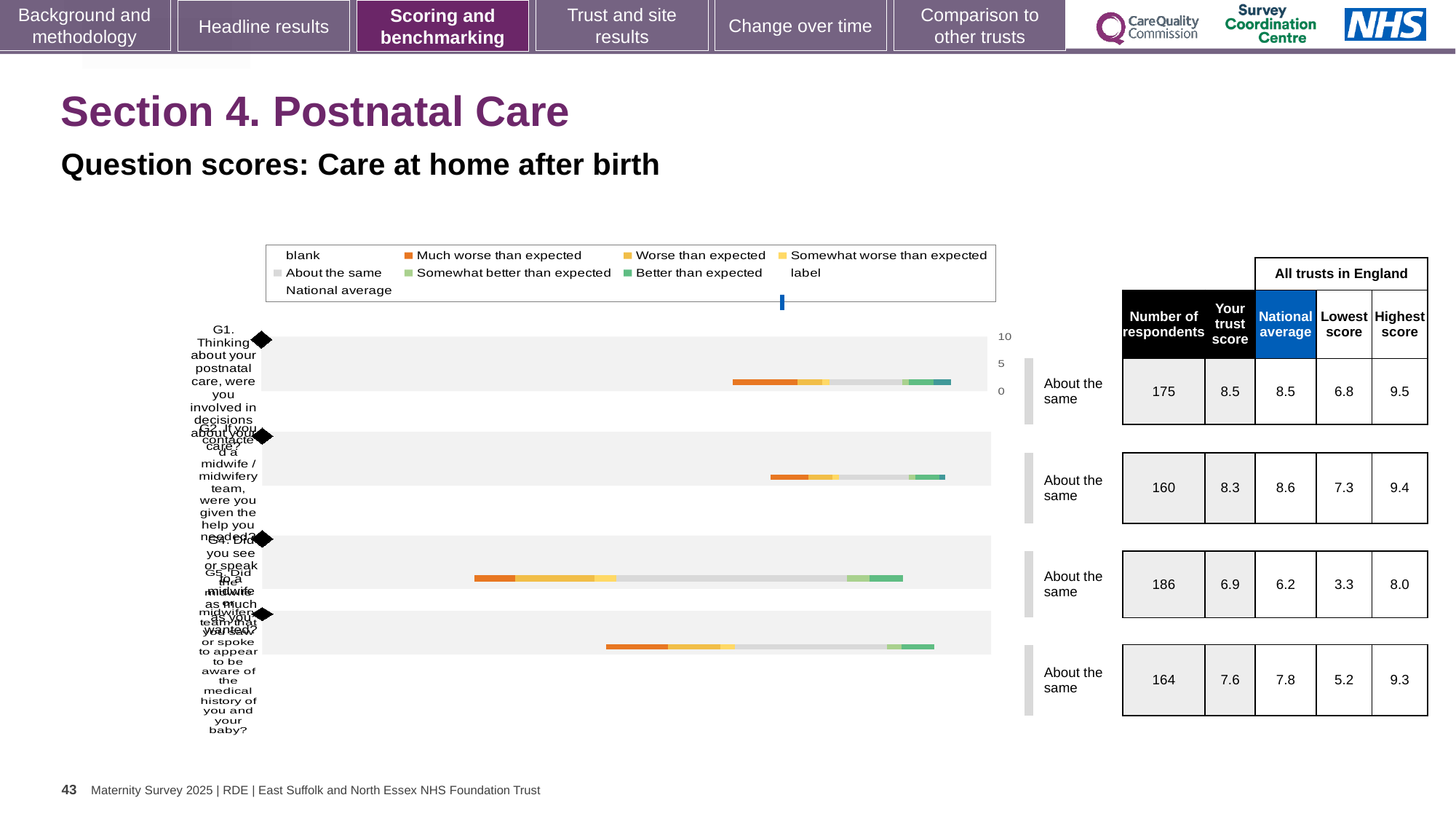
What is the highest score across all trusts in England for the third question bar? 8.0 How many question bars are plotted in the chart? 4 What is the trust score for question G1 (Thinking about your postnatal care, were you involved in decisions about your care?)? 8.5 What benchmark category is shown next to each of the four question bars? About the same How many entries does the chart legend list? 9 What kind of chart is shown on the slide? bar chart Which question bar has the lowest trust score? the third bar (6.9) What is the lowest score across all trusts in England for the fourth question bar? 5.2 What is the national average for the second question bar (G2)? 8.6 What is the number of respondents for question G1 (Thinking about your postnatal care, were you involved in decisions about your care?)? 175 What is the difference between the trust score for the first question bar and the trust score for the third question bar? 1.6 For the third question bar, which is larger: the trust score or the national average? the trust score (6.9)